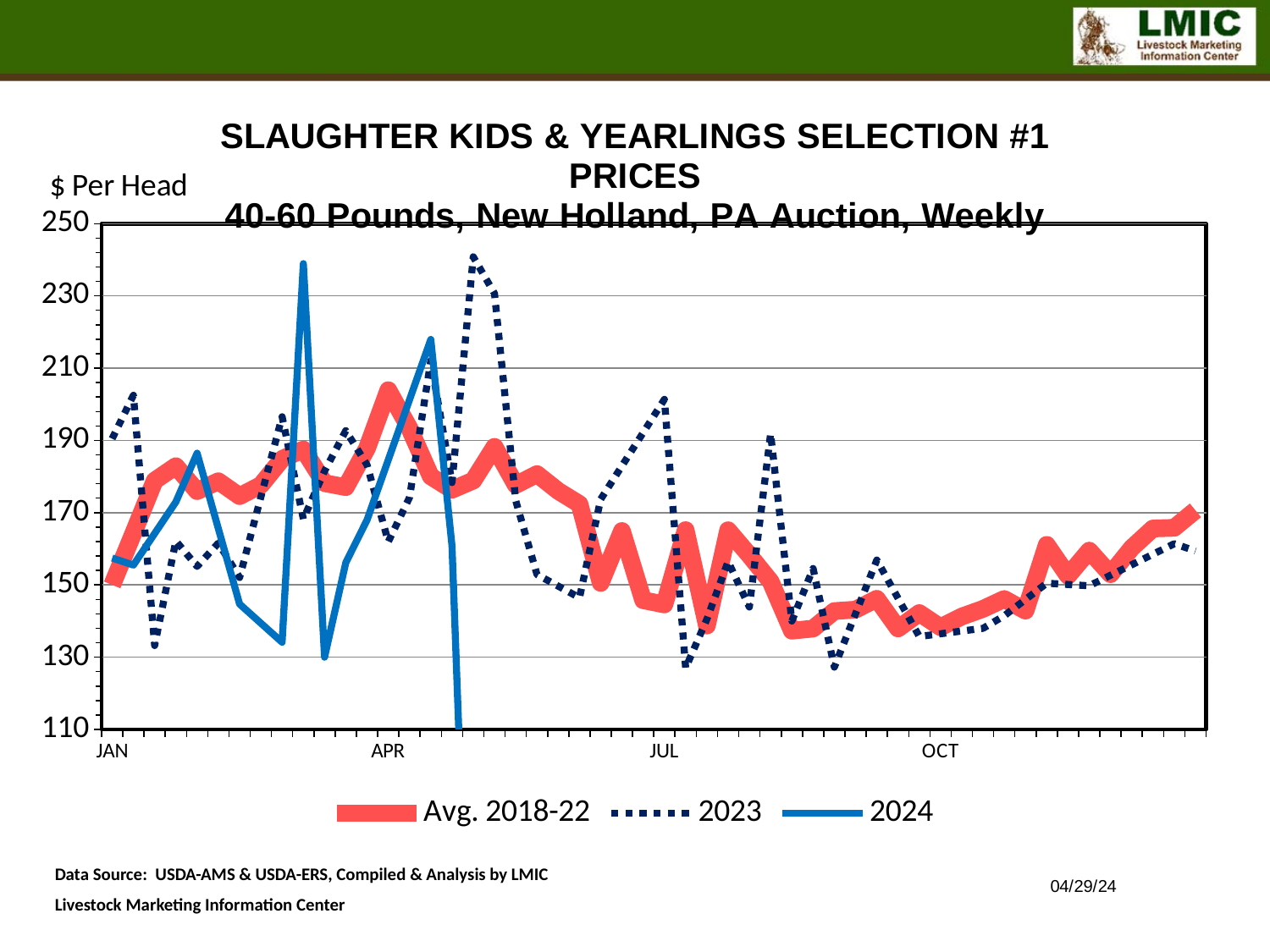
Does the Avg. 2018-22 series generally rise or fall from July to October? Fall At the start of January, which series has the higher value, 2023 or 2024? 2023 Is the peak value of the 2023 series in May greater or less than 230? greater Is the value of the 2024 series at the start of January greater or less than 170? less What kind of chart is shown on the slide? Line chart What is the unit label shown on the y axis? $ Per Head Is the peak value of the 2024 series in March greater or less than 230? greater How many month labels are shown along the x axis? 4 How many series does the legend list? 3 What are the three series listed in the legend? Avg. 2018-22, 2023, 2024